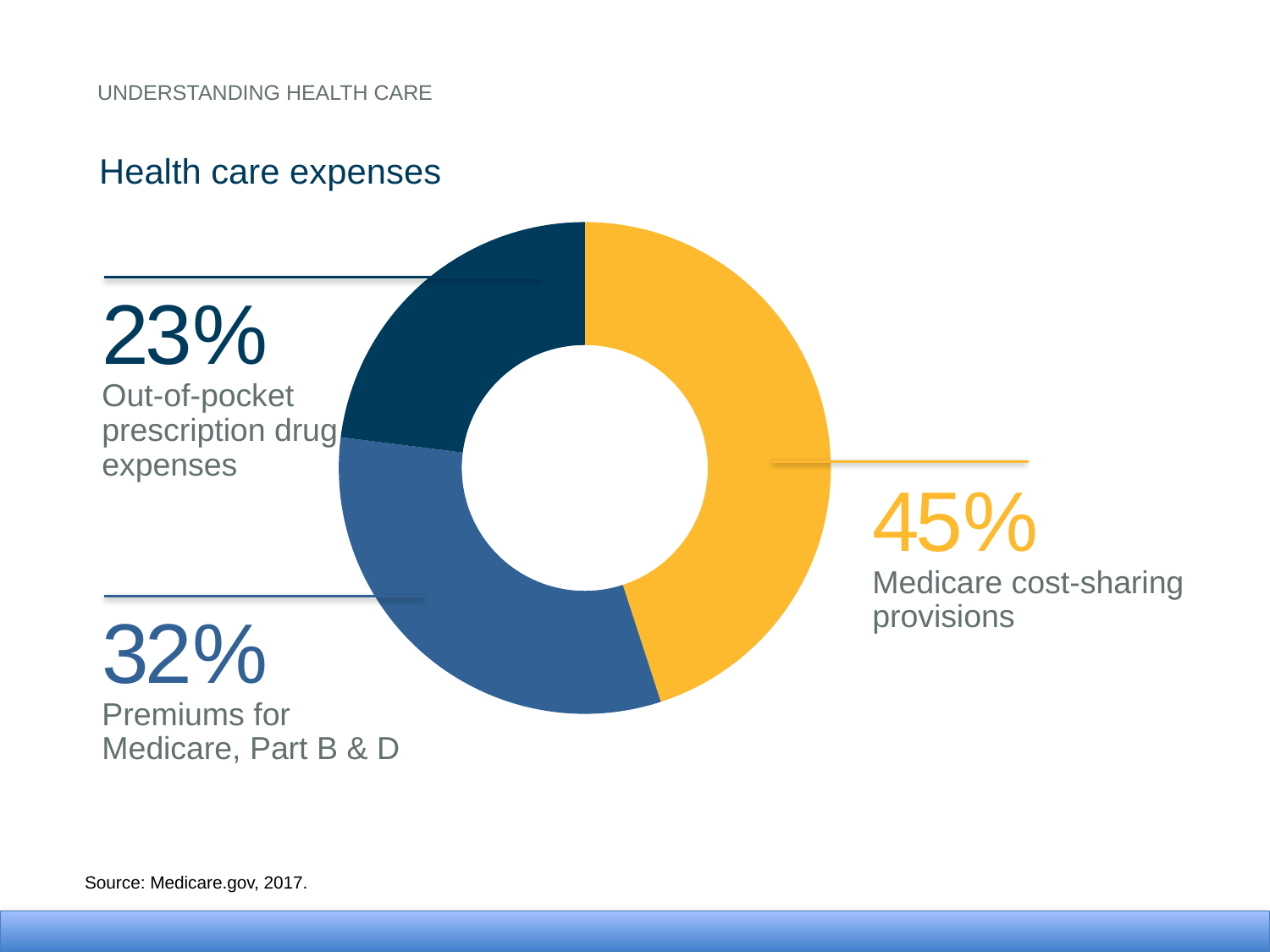
What percentage of health care expenses goes to premiums for Medicare, Part B & D? 32% How many categories are shown in the chart? 3 Which category accounts for the largest share of health care expenses? Medicare cost-sharing provisions What colour represents Medicare cost-sharing provisions in the chart? Yellow Which is larger: the share for premiums for Medicare, Part B & D or the share for out-of-pocket prescription drug expenses? Premiums for Medicare, Part B & D What percentage of health care expenses is out-of-pocket prescription drug expenses? 23% What is the title of the chart? Health care expenses What percentage of health care expenses is attributed to Medicare cost-sharing provisions? 45% What kind of chart is shown on the slide? Pie chart (donut) Which category accounts for the smallest share of health care expenses? Out-of-pocket prescription drug expenses What is the difference in percentage points between Medicare cost-sharing provisions and premiums for Medicare, Part B & D? 13 What is the difference in percentage points between premiums for Medicare, Part B & D and out-of-pocket prescription drug expenses? 9